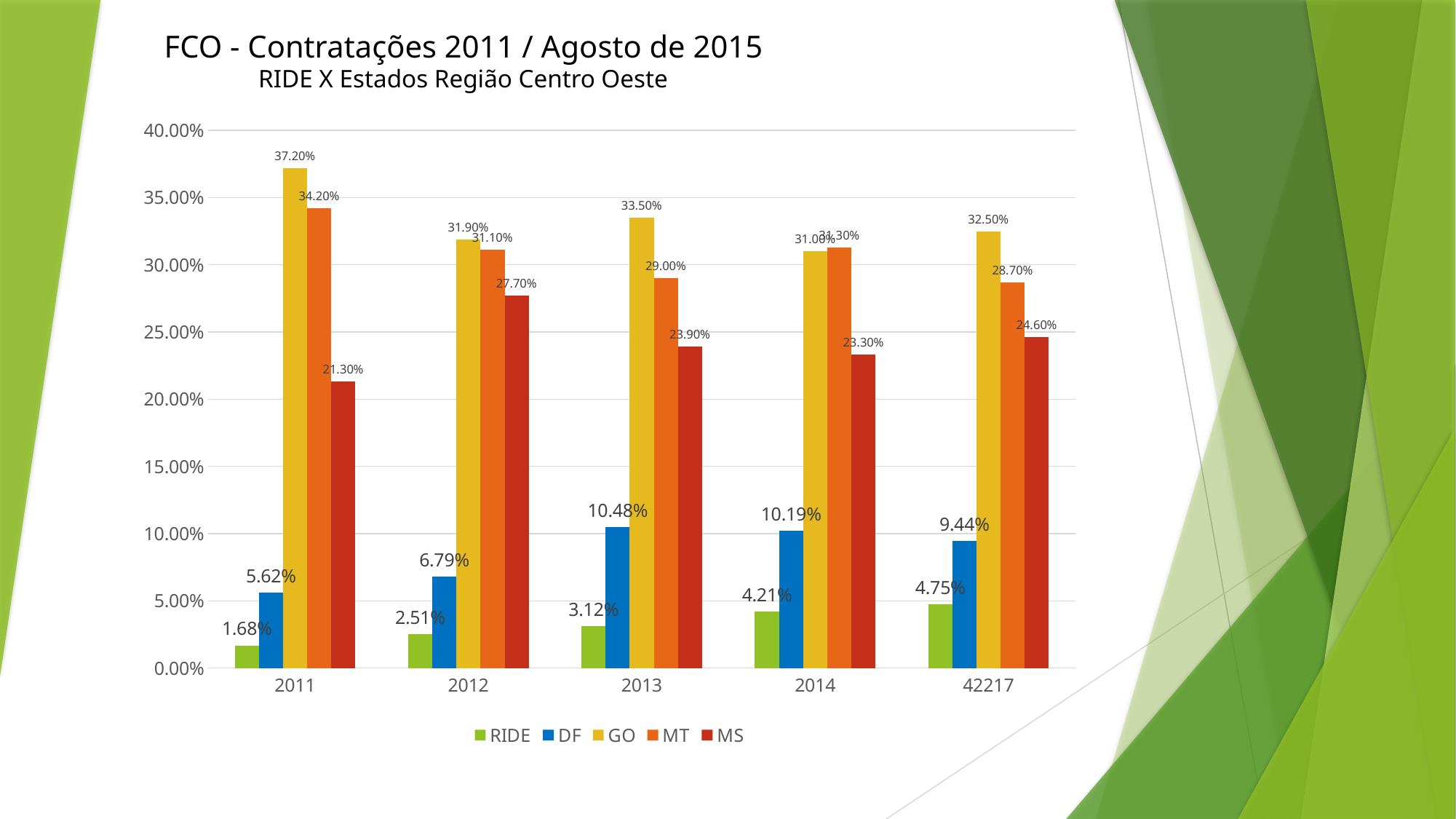
In which category does GO reach its highest value? 2011 What kind of chart is shown on the slide? bar chart Do the RIDE values rise or fall from 2011 to the last category? rise What is the value for GO in 2011? 37.20% Is the value for MS in 2011 greater or less than 20.00%? greater What is the difference between the GO and MT values in 2011? 3.00% What is the value for DF in the category labelled 42217? 9.44% How many categories are shown on the x axis? 5 Which is larger, the MS value in 2012 or the MS value in 2013? 2012 How many series does the legend list? 5 In which category is the RIDE value lowest? 2011 What is the value for RIDE in 2013? 3.12%